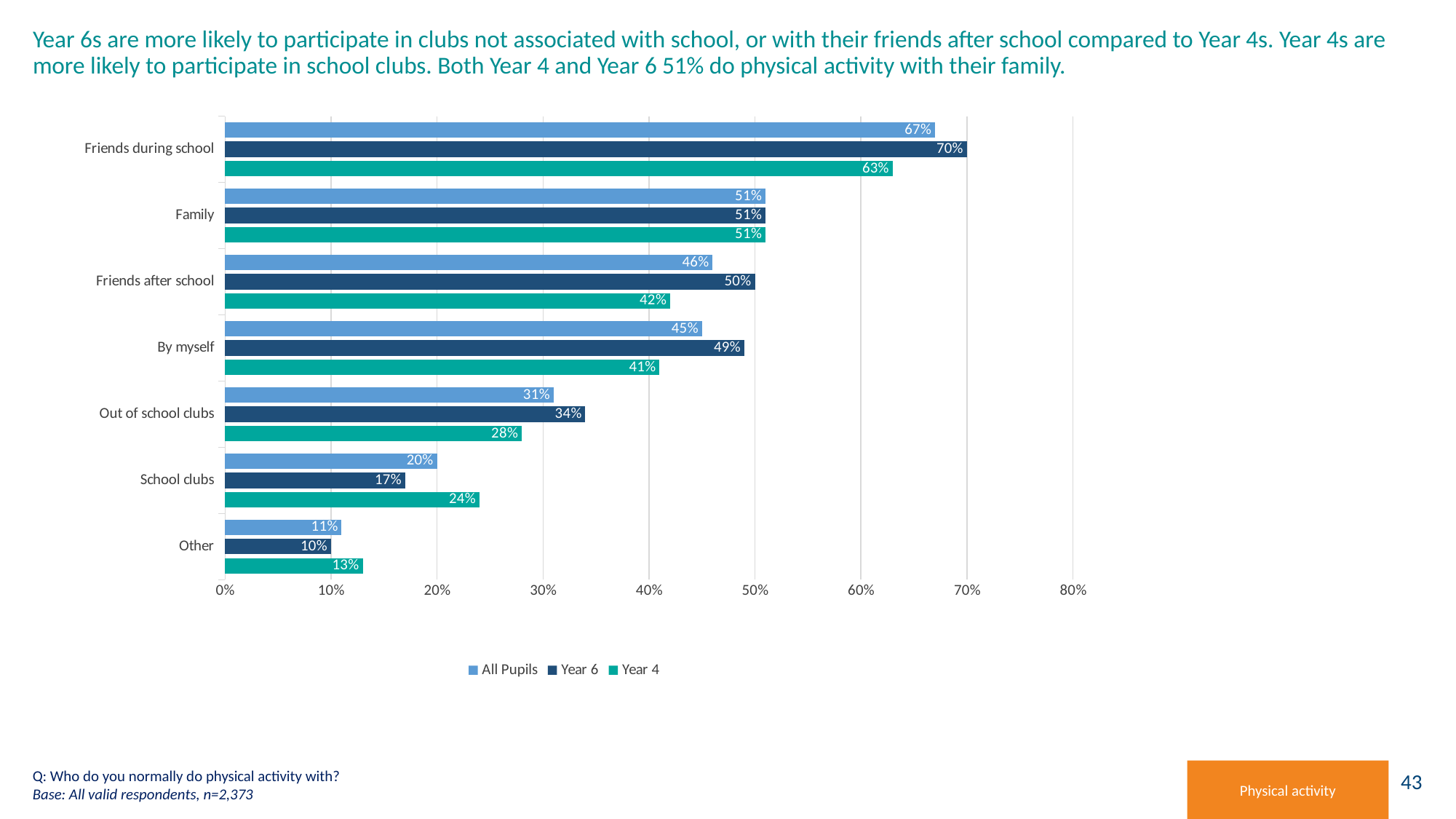
Which category has the lowest value for Year 6? Other How many categories are shown on the y axis of the chart? 7 Which is larger for School clubs: the Year 6 value or the Year 4 value? Year 4 Which category has the highest value for Year 4? Friends during school What kind of chart is shown on the slide? Bar chart What is the All Pupils value for Out of school clubs? 31% What is the Year 4 value for School clubs? 24% What is the difference between the Year 6 and Year 4 values for Friends after school? 8 percentage points Is the Year 4 value for By myself greater or less than 40%? greater How many series does the legend list? 3 What percentage of Year 6 pupils do physical activity with friends during school? 70% Which series is shown in dark blue in the legend? Year 6